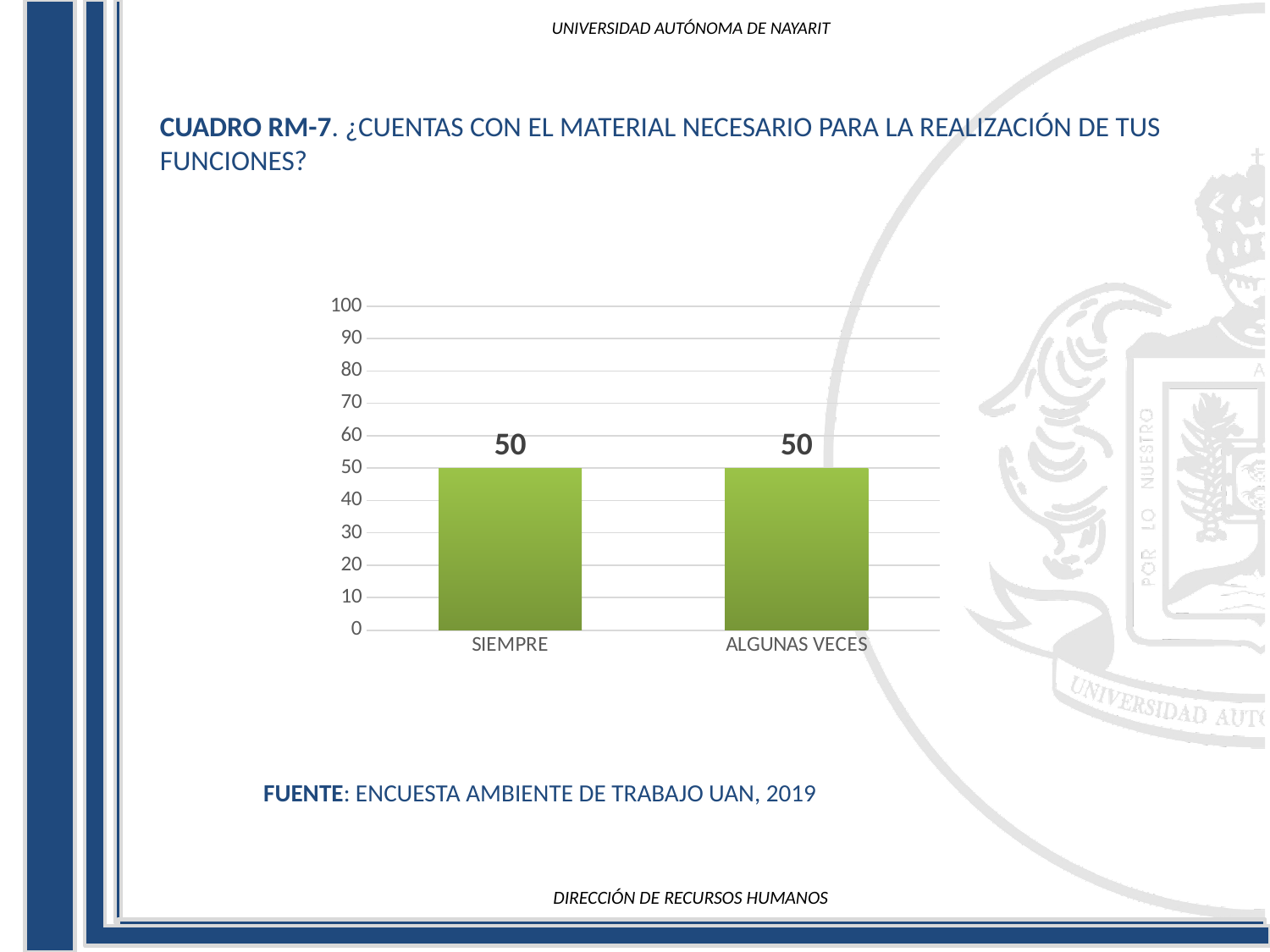
How many categories are shown on the x axis? 2 What colour are the bars in the chart? green Is the value for SIEMPRE greater or less than 70? less What is the maximum value shown on the y axis? 100 What is the value for ALGUNAS VECES? 50 Is the value for ALGUNAS VECES greater or less than 30? greater What is the total of the values for SIEMPRE and ALGUNAS VECES? 100 What is the difference between the values for SIEMPRE and ALGUNAS VECES? 0 What kind of chart is shown on the slide? bar chart What is the value for SIEMPRE? 50